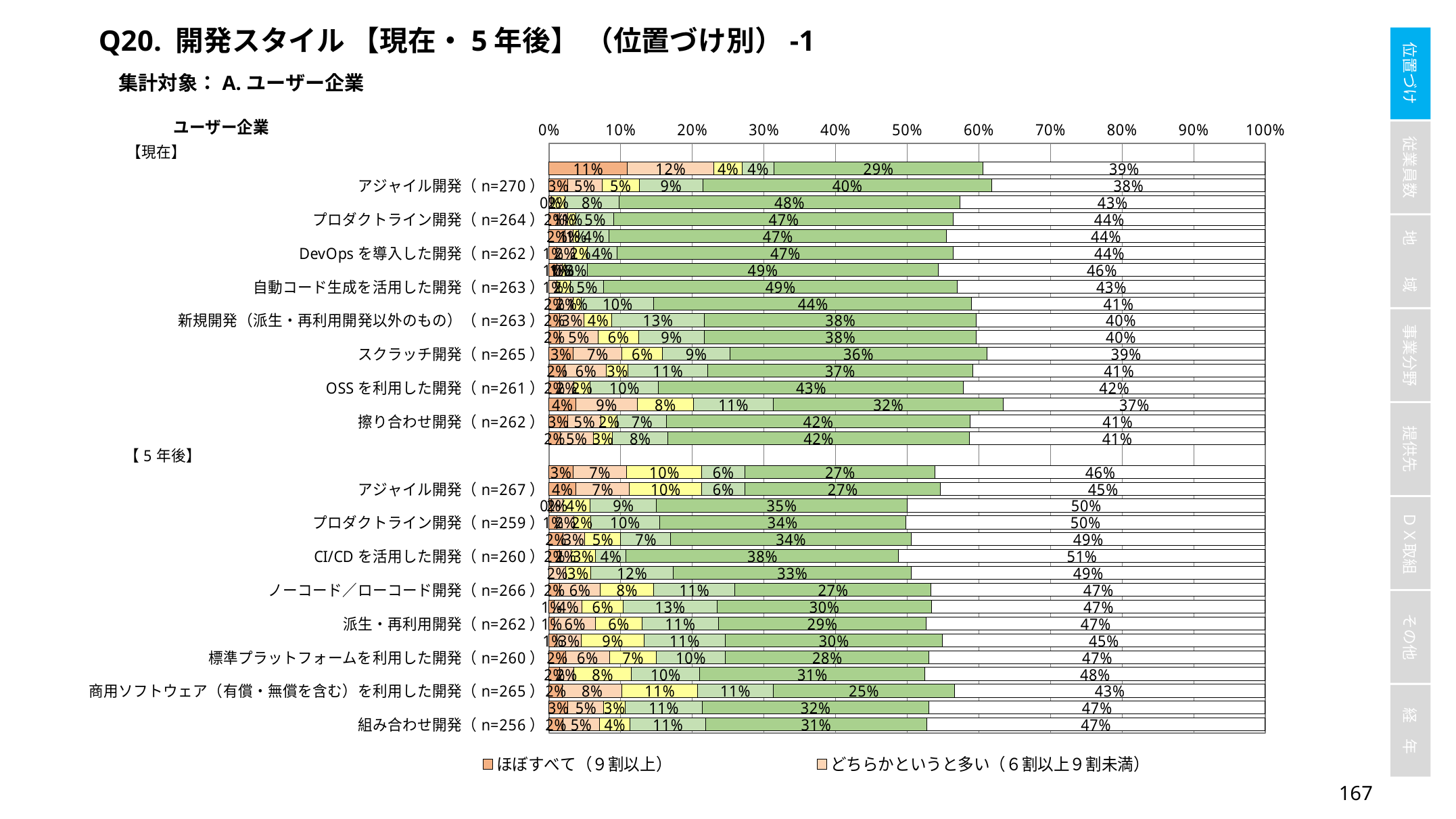
In the row labelled 商用ソフトウェア（有償・無償を含む）を利用した開発（n=265）under 【5年後】, what is the value of the largest green segment? 25% What kind of chart is shown on the slide? bar chart In the row labelled 組み合わせ開発（n=256）under 【5年後】, what is the value of the rightmost (white) segment? 47% In the row labelled アジャイル開発（n=267）under 【5年後】, what is the value of the rightmost (white) segment? 45% In the row labelled 擦り合わせ開発（n=262）under 【現在】, what is the value of the rightmost (white) segment? 41% What is the first legend entry of the chart? ほぼすべて（9割以上） How many series does the legend list? 2 In the row labelled アジャイル開発（n=270）under 【現在】, what is the value of the rightmost (white) segment? 38% In the row labelled アジャイル開発（n=270）under 【現在】, what is the value of the largest green segment? 40% What is the maximum value shown on the horizontal axis of the chart? 100%